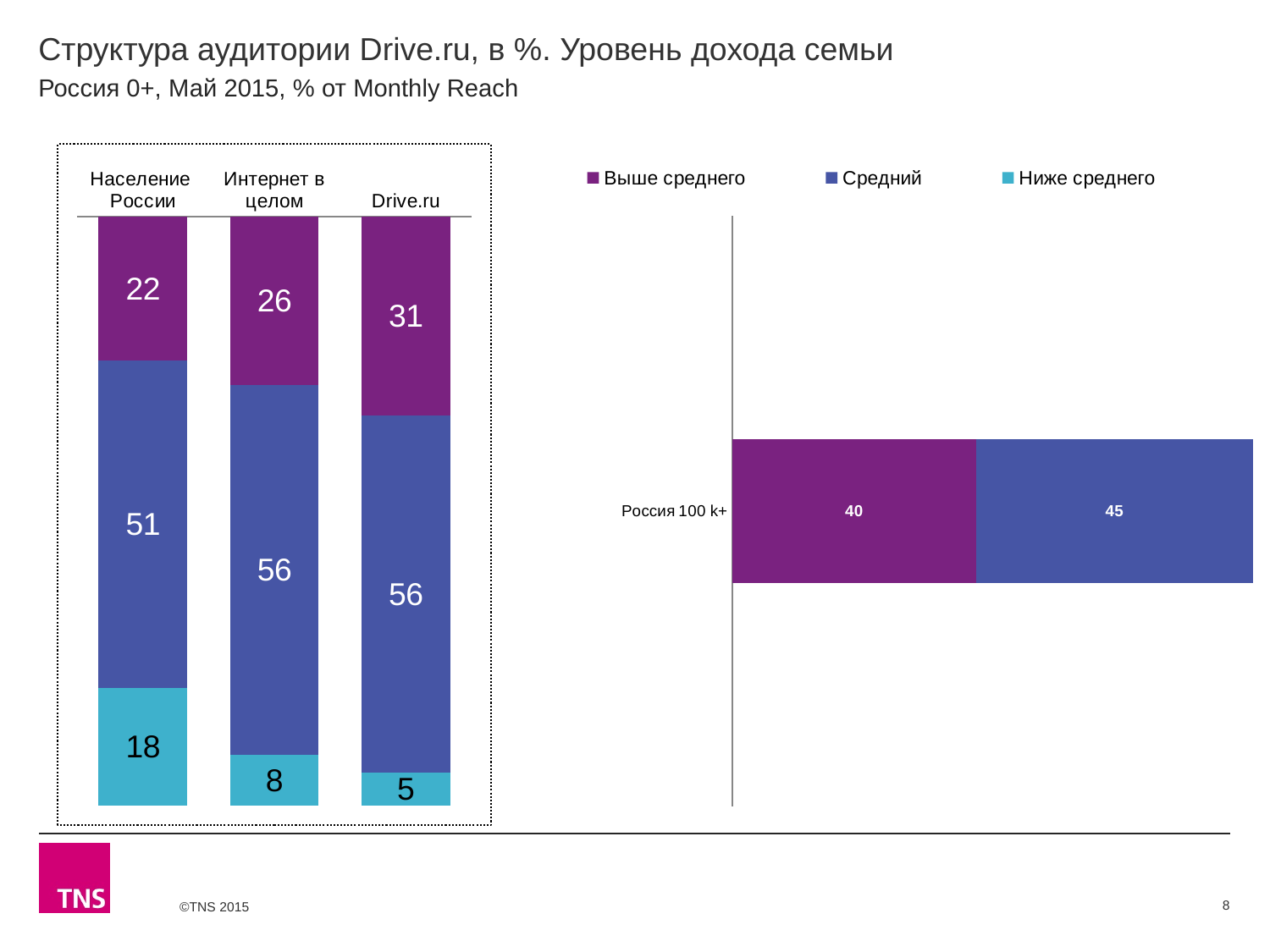
In the left chart, what is the difference between the Выше среднего values for Drive.ru and Население России? 9 In the left chart, what is the value of the Средний segment for Drive.ru? 56 In the left chart, which category has the highest Выше среднего value? Drive.ru In the right chart, what is the value of the Средний segment for Россия 100 k+? 45 In the left chart, which category has the lowest Ниже среднего value? Drive.ru In the left chart, what is the value of the Ниже среднего segment for Население России? 18 In the right chart, what is the total of the Россия 100 k+ bar? 85 How many categories are shown in the left chart? 3 In the left chart, what is the value of the Выше среднего segment for Интернет в целом? 26 In the left chart, which is larger: the Ниже среднего value for Интернет в целом or for Drive.ru? Интернет в целом How many series does the legend list? 3 What kind of chart is the left chart? Stacked bar chart